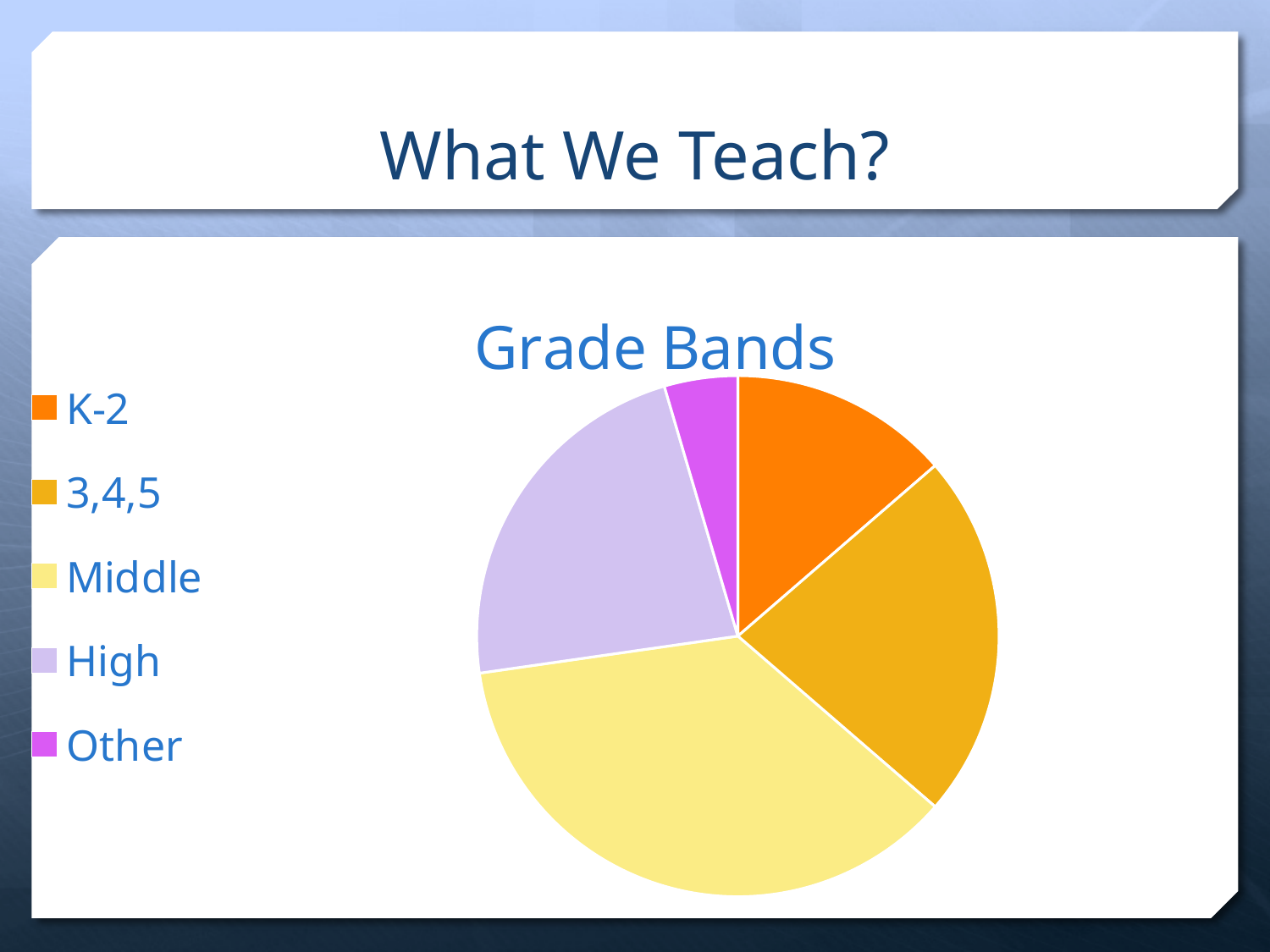
Which slice is larger, Middle or K-2? Middle Which grade band has the smallest slice of the pie? Other Which slice is larger, High or Other? High Which legend entry is shown in orange? K-2 Which slice is larger, K-2 or High? High How many categories (slices) does the pie chart have? 5 How many entries does the legend list? 5 What is the title of the chart? Grade Bands Which grade band has the largest slice of the pie? Middle What kind of chart is shown on the slide? pie chart